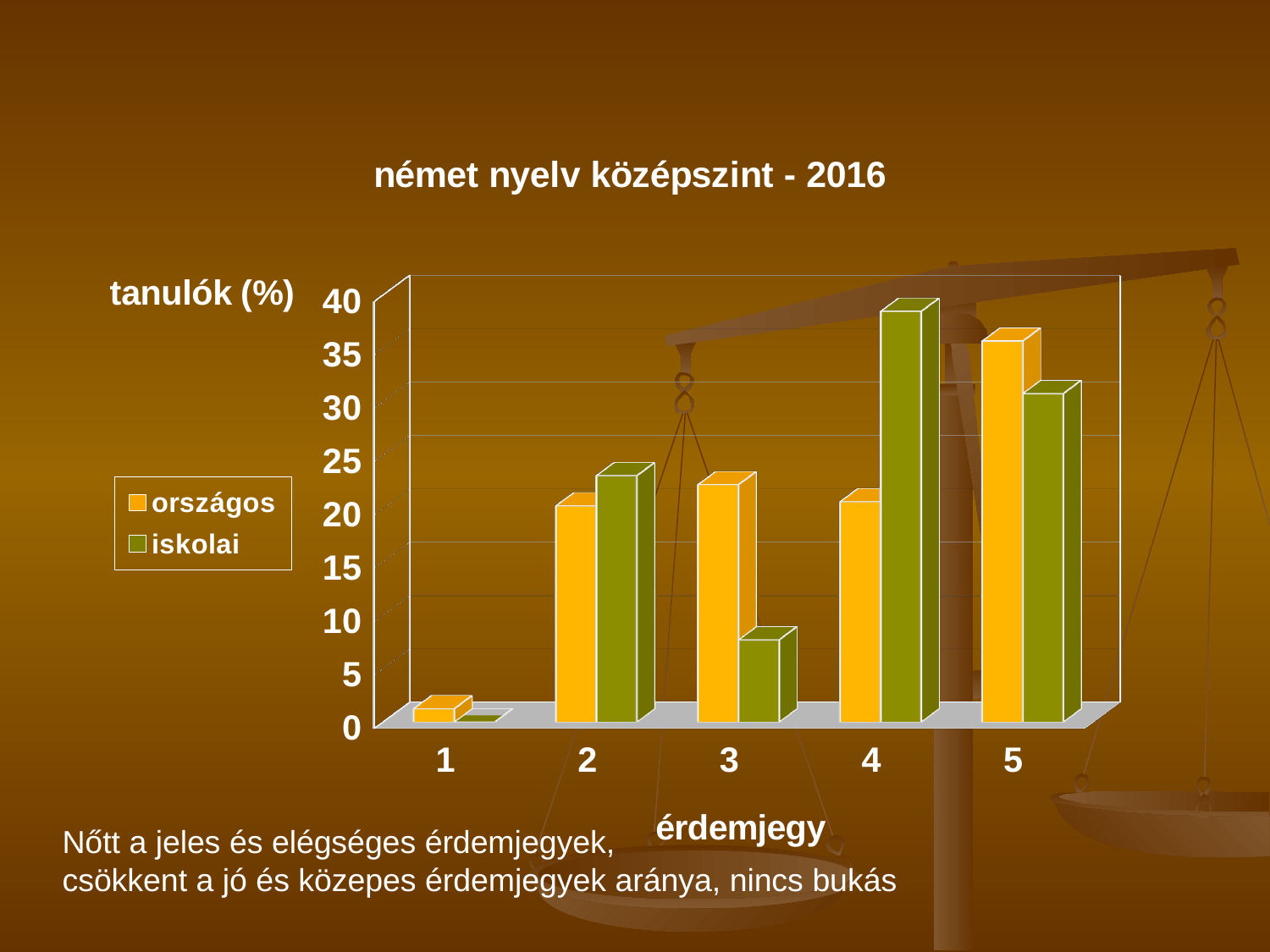
For érdemjegy 3, which series has the larger value, országos or iskolai? országos For which érdemjegy is the iskolai value lowest? 1 What kind of chart is shown on the slide? bar chart Is the iskolai value for érdemjegy 4 greater or less than 35? greater What are the two series named in the legend? országos, iskolai For which érdemjegy is the iskolai value highest? 4 For érdemjegy 4, which series has the larger value, országos or iskolai? iskolai Is the iskolai value for érdemjegy 3 greater or less than 10? less What is the title of the chart? német nyelv középszint - 2016 How many series does the legend list? 2 For which érdemjegy is the országos value highest? 5 How many érdemjegy categories are shown on the x axis? 5